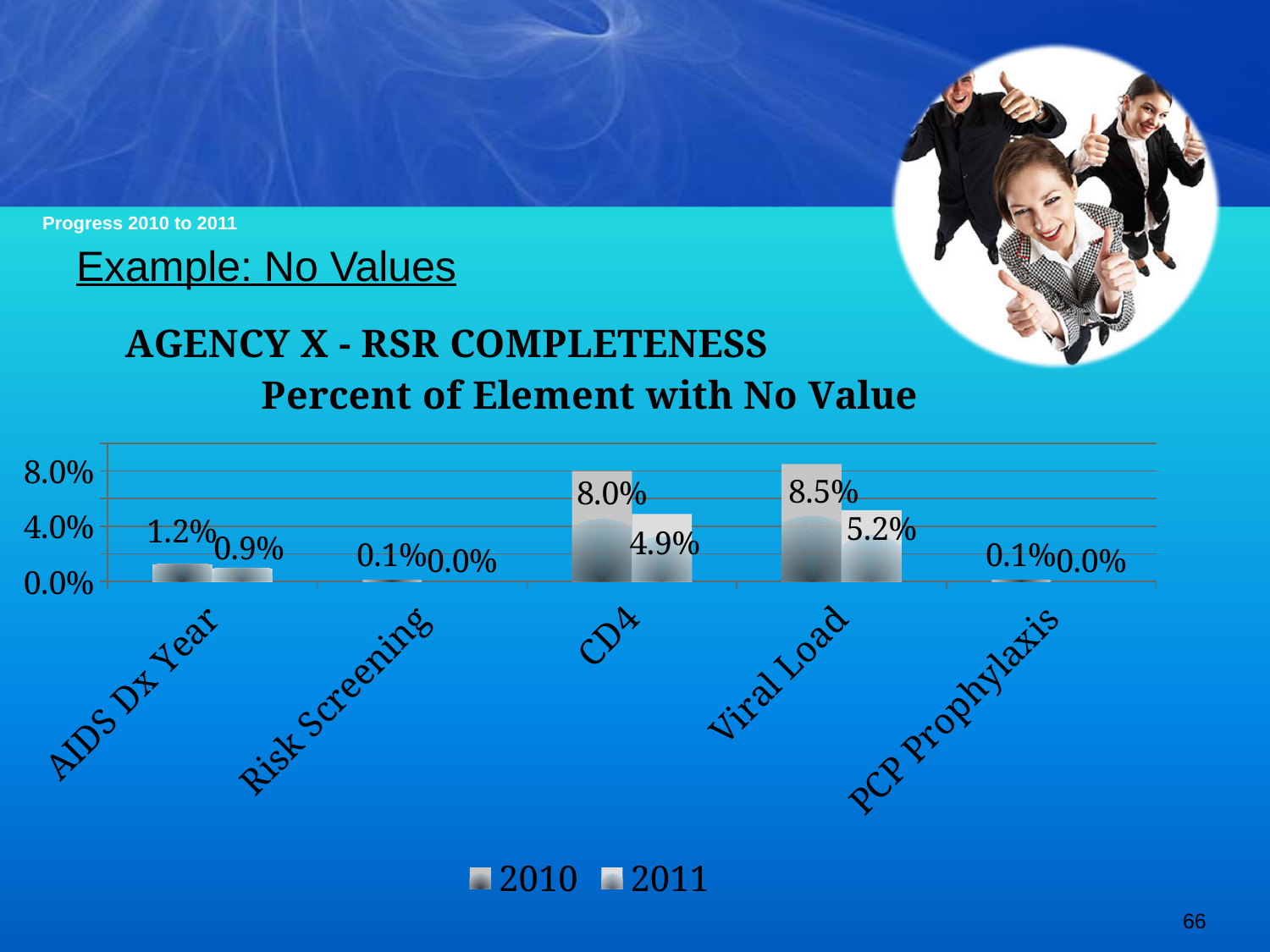
What is the difference between the 2010 and 2011 values for CD4? 3.1% Which category has the highest 2010 value? Viral Load Which category has the highest 2011 value? Viral Load What is the 2010 value for Risk Screening? 0.1% What is the 2011 value for AIDS Dx Year? 0.9% What kind of chart is shown on the slide? bar chart How many categories are shown on the x axis? 5 What is the difference between the 2010 and 2011 values for Viral Load? 3.3% What is the 2010 value for CD4? 8.0% What is the 2011 value for Viral Load? 5.2% Which is larger, the 2010 value for CD4 or the 2010 value for Viral Load? Viral Load How many series does the legend list? 2